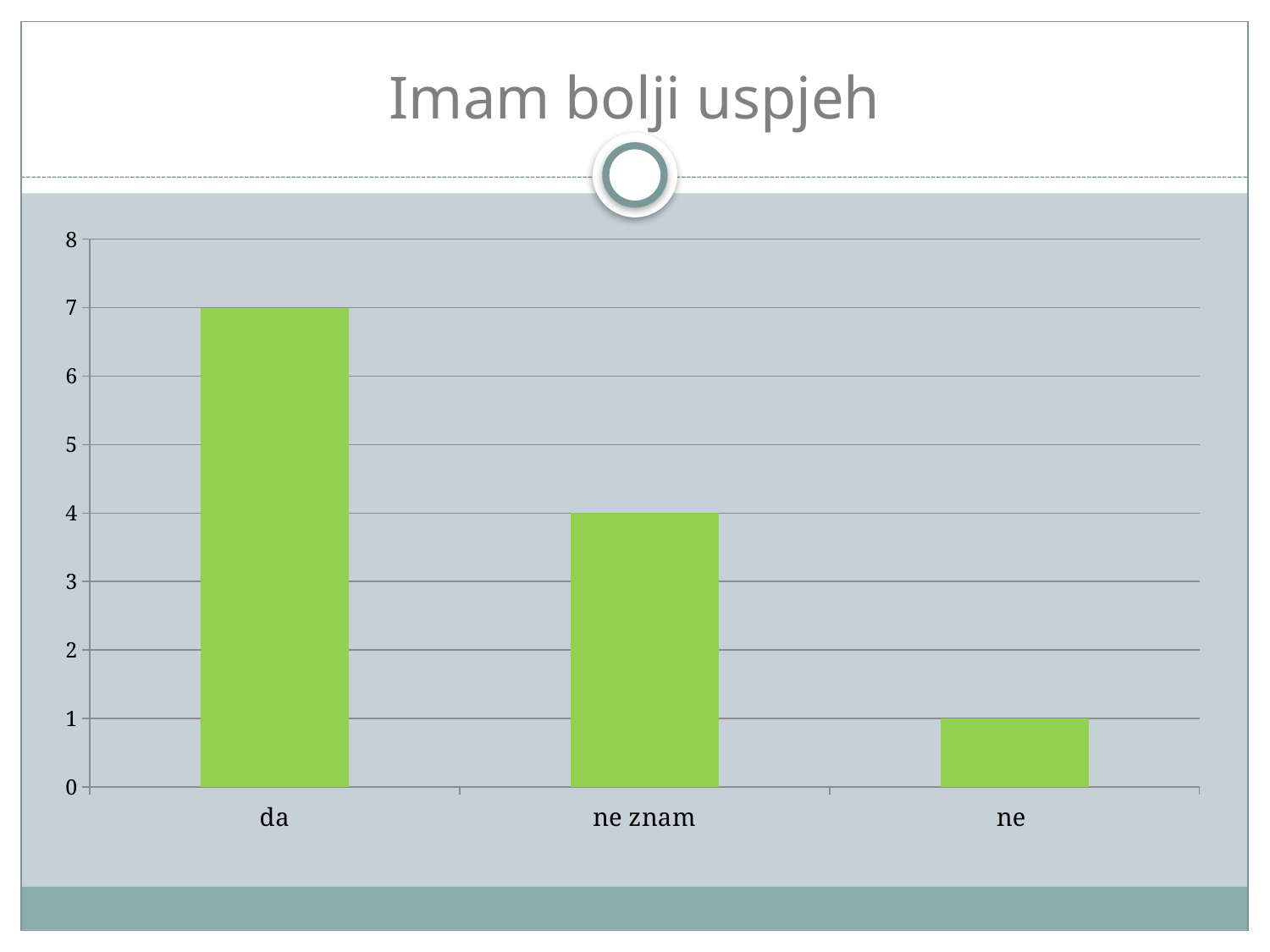
How many categories are shown on the x axis? 3 Is the value for "da" greater or less than 5? greater What kind of chart is shown on the slide? bar chart What is the value for "ne"? 1 What is the value for "da"? 7 What is the value for "ne znam"? 4 What is the difference between the values for "da" and "ne znam"? 3 Which is larger, the value for "ne znam" or the value for "ne"? ne znam What is the difference between the values for "ne znam" and "ne"? 3 Which category has the lowest value? ne Which category has the highest value? da What is the title of the slide? Imam bolji uspjeh